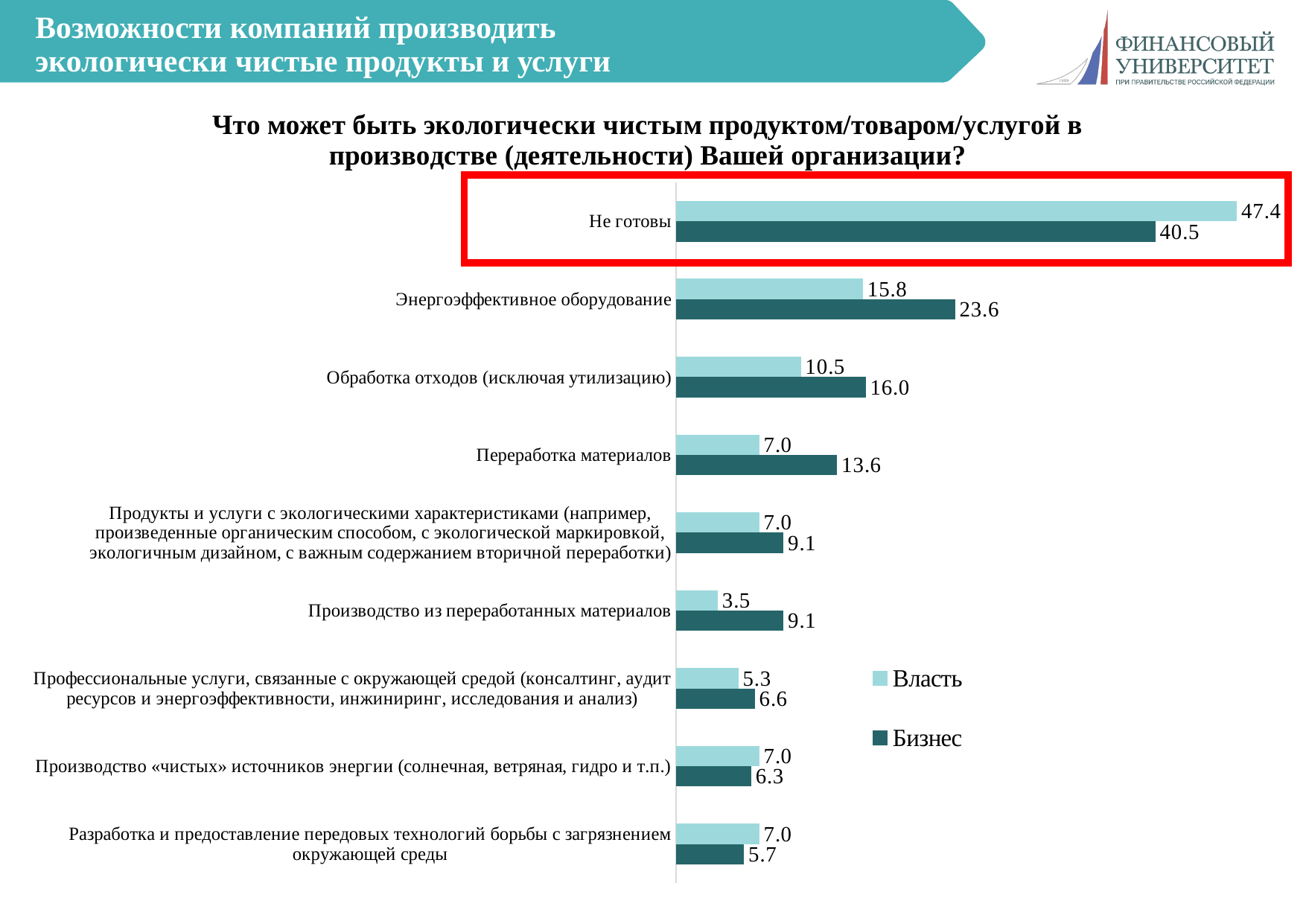
For "Энергоэффективное оборудование", which series has the larger value, Власть or Бизнес? Бизнес What is the difference between the Бизнес and Власть values for "Переработка материалов"? 6.6 What is the difference between the Власть and Бизнес values for "Не готовы"? 6.9 What is the value for Власть in the category "Не готовы"? 47.4 How many categories are shown in the chart? 9 What is the value for Бизнес in the category "Обработка отходов (исключая утилизацию)"? 16.0 What kind of chart is shown on the slide? Bar chart How many series does the legend list? 2 Which category has the lowest value for the Власть series? Производство из переработанных материалов Which category has the highest value for the Бизнес series? Не готовы For "Производство «чистых» источников энергии (солнечная, ветряная, гидро и т.п.)", which series has the larger value, Власть or Бизнес? Власть What is the value for Бизнес in the category "Энергоэффективное оборудование"? 23.6